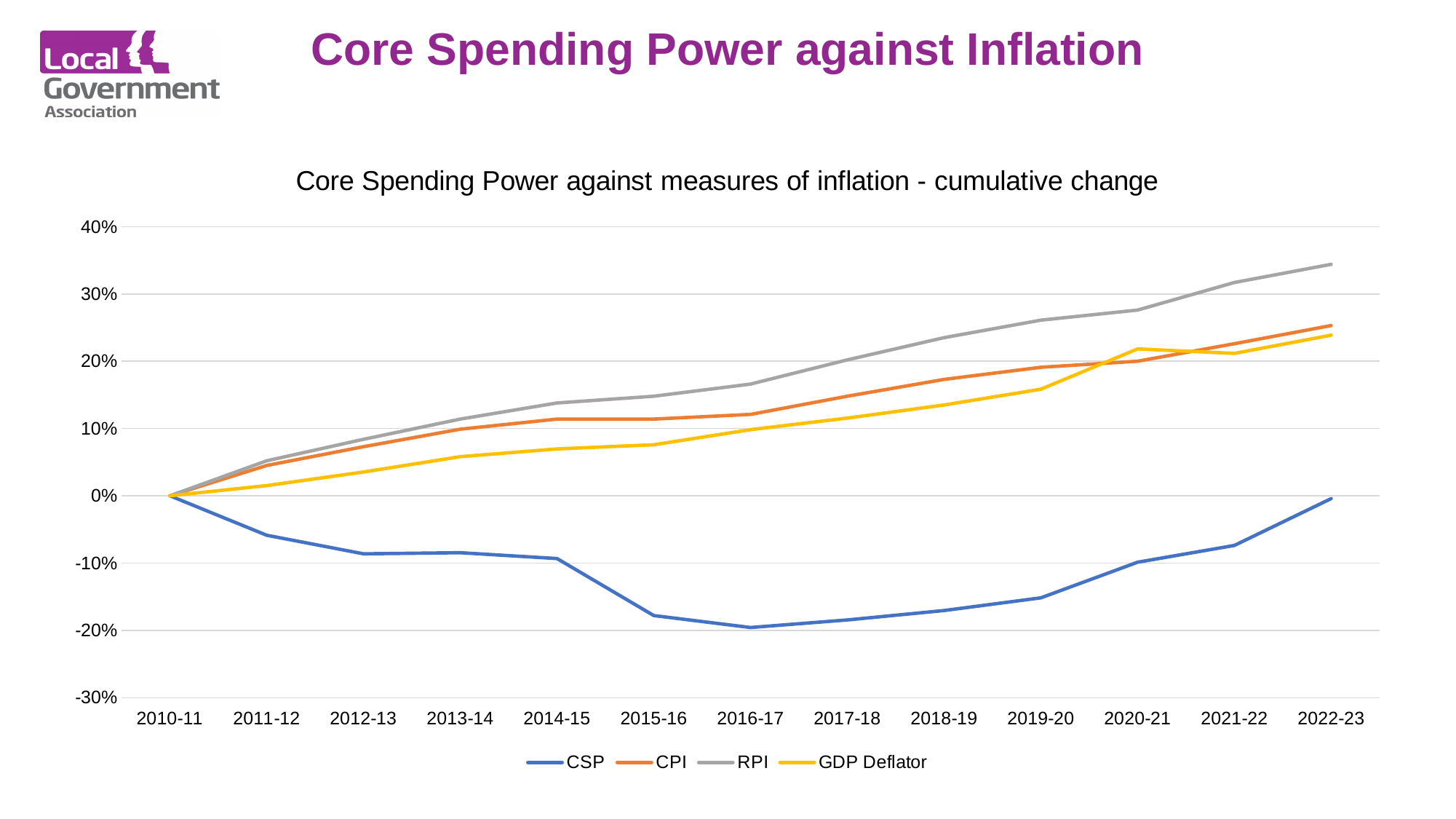
Which series has the lowest value in 2022-23? CSP In 2019-20, which is larger, RPI or CPI? RPI How many years are shown along the x axis? 13 Which series has the highest value in 2022-23? RPI What kind of chart is shown on the slide? line chart Is the value for CSP in 2016-17 greater or less than -10%? less What is the value of CSP in 2010-11? 0% How many series does the legend list? 4 Does the RPI line rise or fall from 2010-11 to 2022-23? rise Is the value for RPI in 2022-23 greater or less than 30%? greater Is the value for GDP Deflator in 2015-16 greater or less than 10%? less In which year does the CSP line reach its lowest point? 2016-17